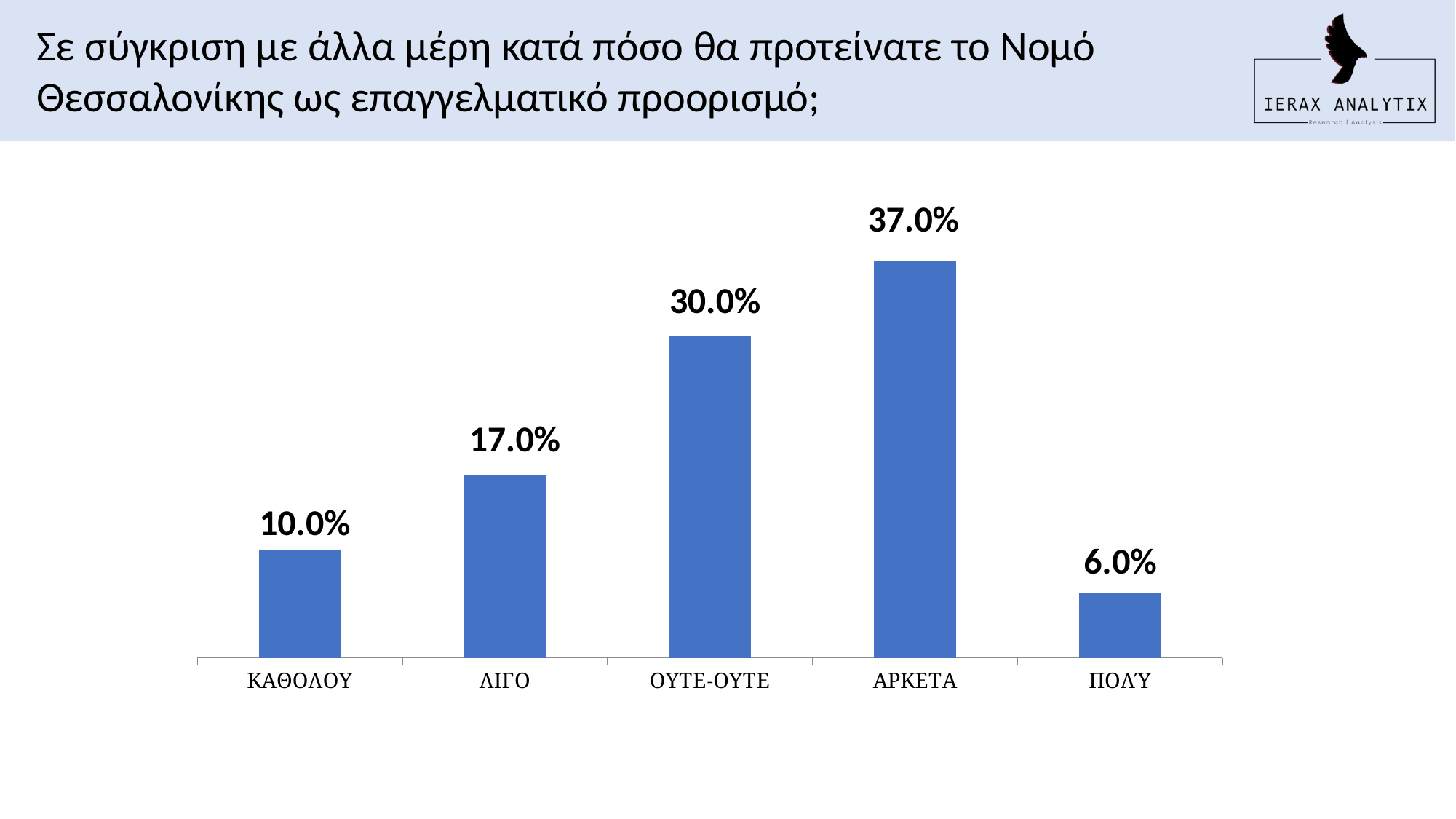
What is the value for ΑΡΚΕΤΑ? 37.0% What is the difference between the values for ΑΡΚΕΤΑ and ΟΥΤΕ-ΟΥΤΕ? 7.0% How many categories are shown in the chart? 5 What is the value for ΟΥΤΕ-ΟΥΤΕ? 30.0% What is the value for ΠΟΛΎ? 6.0% What is the value for ΚΑΘΟΛΟΥ? 10.0% Which category has the highest value? ΑΡΚΕΤΑ What is the difference between the values for ΚΑΘΟΛΟΥ and ΠΟΛΎ? 4.0% Which category has the lowest value? ΠΟΛΎ What kind of chart is shown on the slide? Bar chart Which is larger, the value for ΛΙΓΟ or the value for ΚΑΘΟΛΟΥ? ΛΙΓΟ What is the value for ΛΙΓΟ? 17.0%